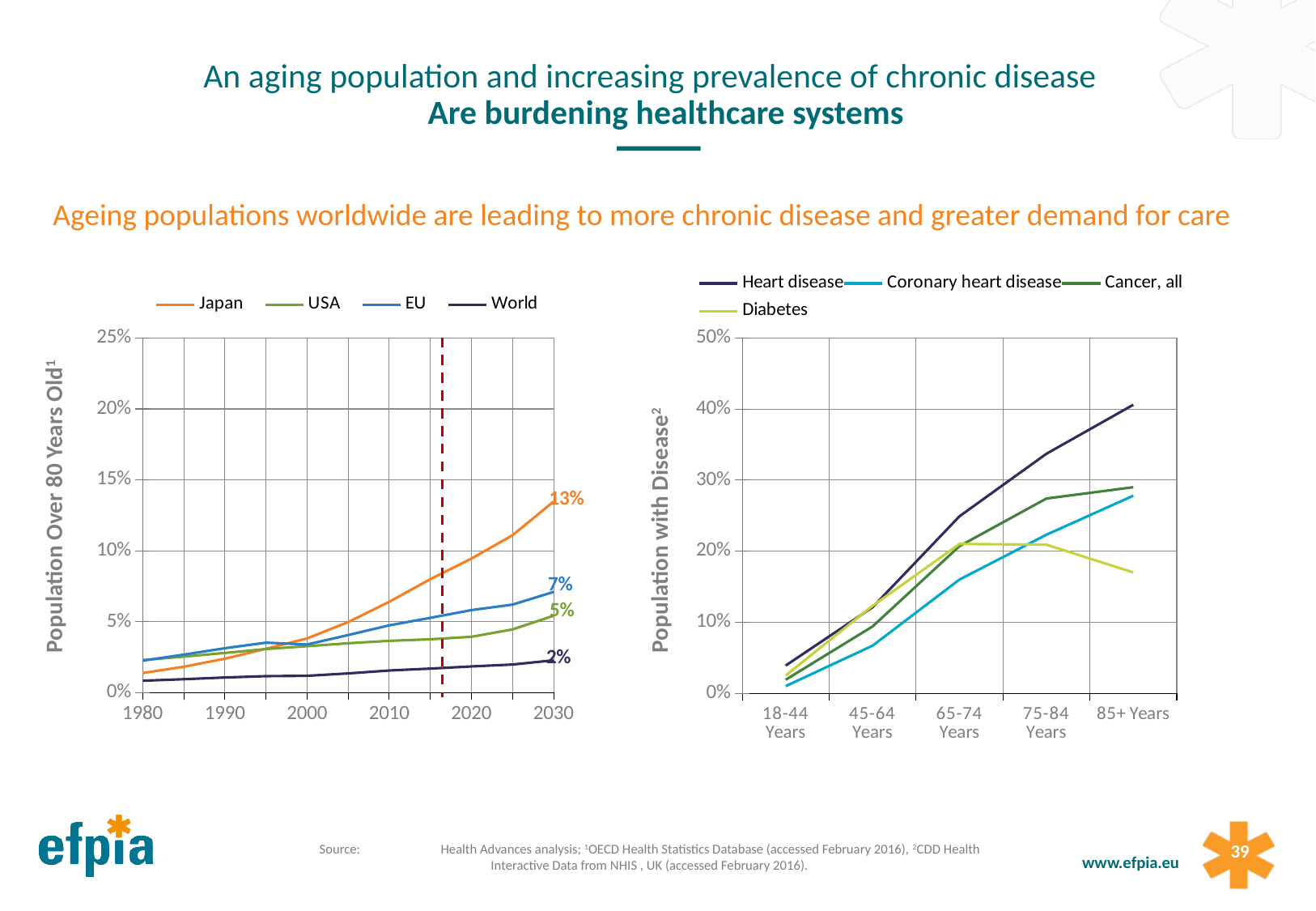
In the right chart (Population with Disease), is the value for Heart disease at 85+ Years greater or less than 30%? greater In the right chart (Population with Disease), how many age categories are shown on the x axis? 5 In the left chart (Population Over 80 Years Old), what is the value for the EU in 2030? 7% In the left chart (Population Over 80 Years Old), what is the value for Japan in 2030? 13% In the left chart (Population Over 80 Years Old), how many series does the legend list? 4 In the right chart (Population with Disease), how many series does the legend list? 4 In the left chart (Population Over 80 Years Old), what is the value for the World in 2030? 2% In the right chart (Population with Disease), which series has the highest value for 85+ Years? Heart disease In the left chart (Population Over 80 Years Old), does the Japan line rise or fall from 1980 to 2030? rise In the left chart (Population Over 80 Years Old), what is the difference between the Japan and USA values in 2030? 8% What kind of chart is the right chart (Population with Disease)? line chart In the left chart (Population Over 80 Years Old), which series has the highest value in 2030? Japan